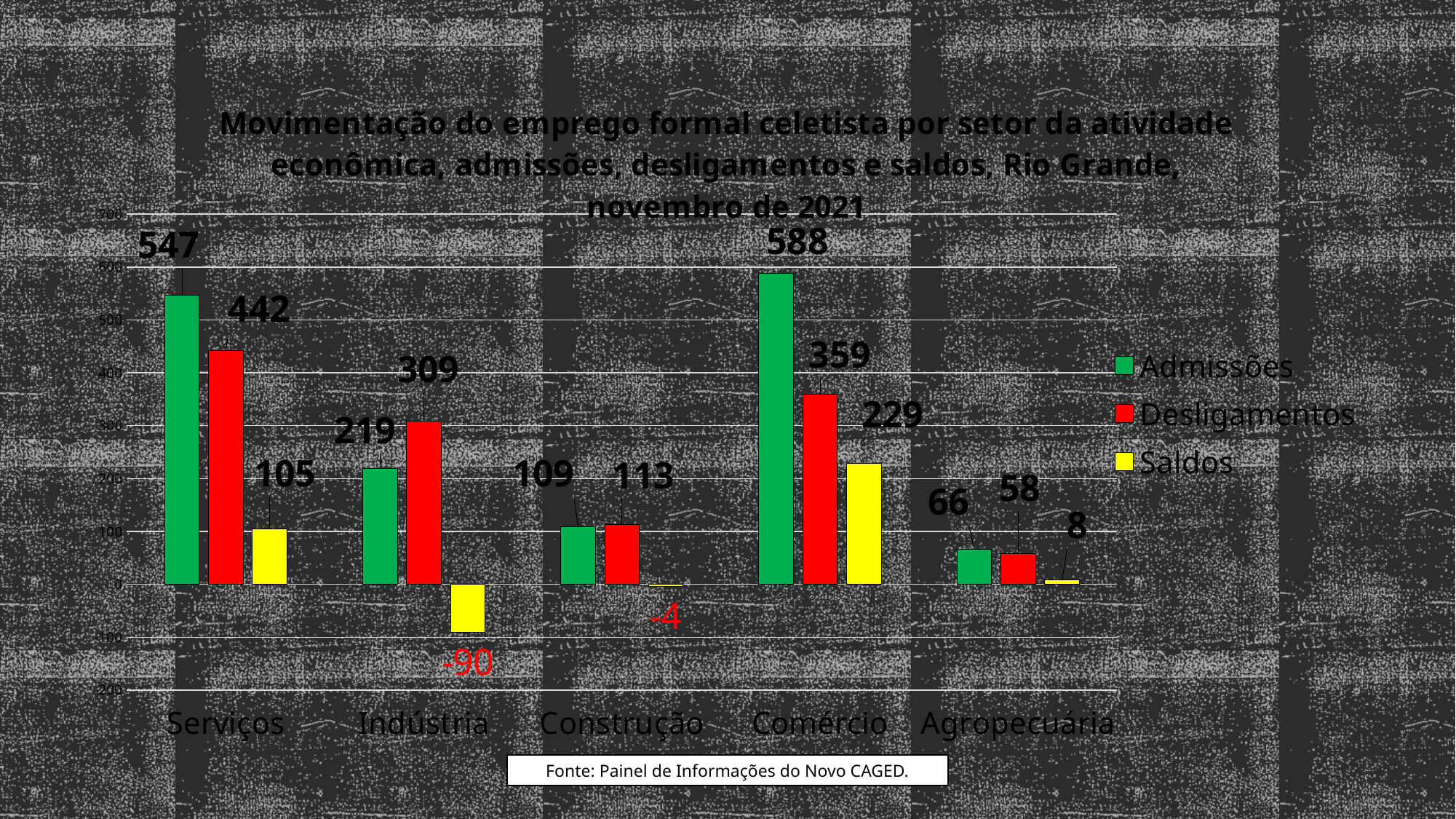
Which is larger for Indústria, Admissões or Desligamentos? Desligamentos How many sectors are shown on the x axis? 5 Which sector has the highest value for Admissões? Comércio How many series does the legend list? 3 What is the value of Desligamentos for Indústria? 309 What is the value of Saldos for Construção? -4 What is the value of Admissões for Serviços? 547 What colour are the Saldos bars? Yellow What is the value of Saldos for Agropecuária? 8 What kind of chart is shown on the slide? Bar chart Which sector has the lowest value for Saldos? Indústria What is the difference between Admissões and Desligamentos for Comércio? 229